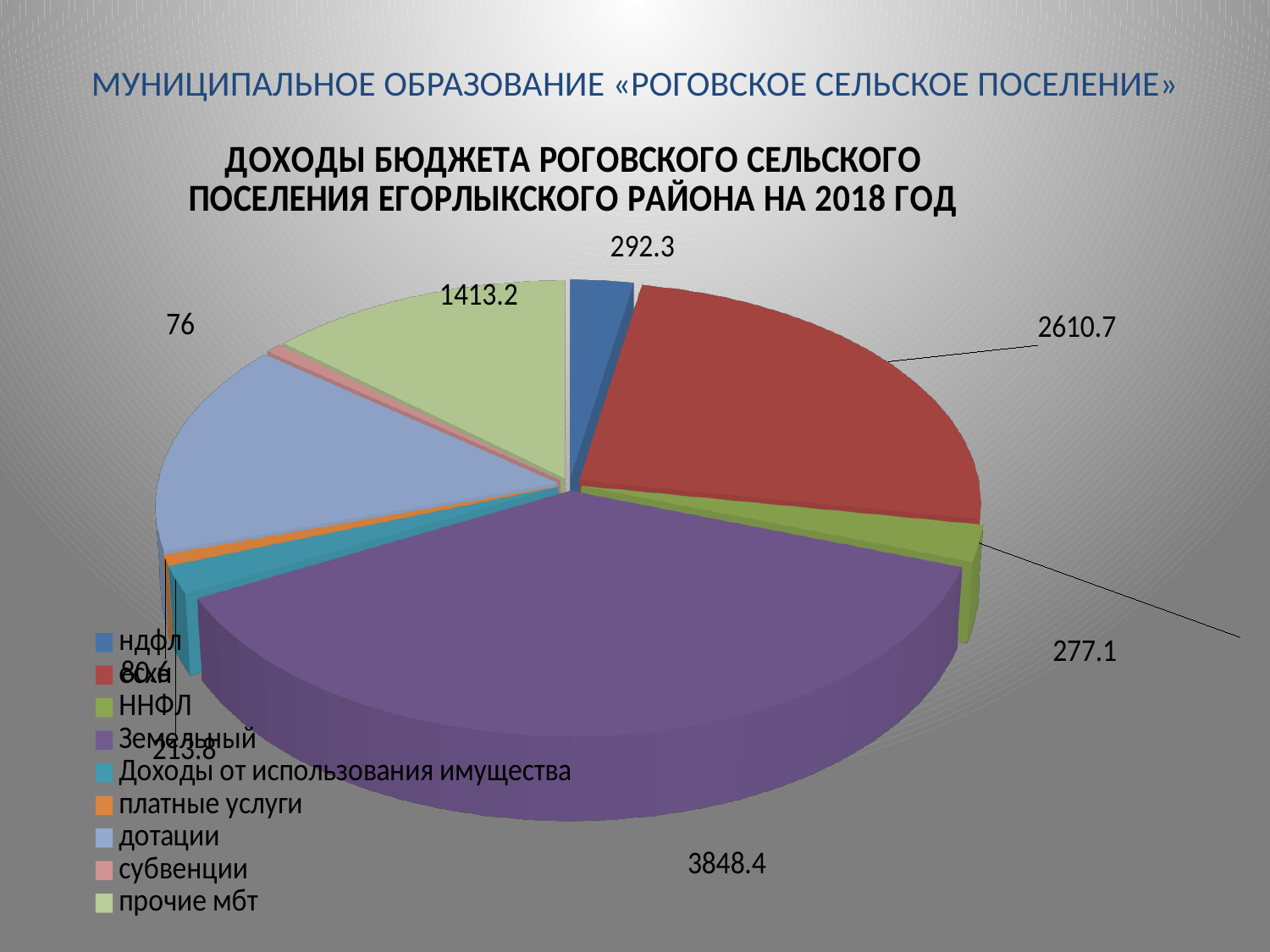
What is the value shown for the ндфл slice? 292.3 Which category has the largest slice in the pie chart? Земельный What is the difference between the есхн value and the ндфл value? 2318.4 How many categories does the legend of the pie chart list? 9 What is the value shown for the Земельный slice? 3848.4 Which is larger, the есхн slice or the ндфл slice? есхн What is the value shown for the есхн slice? 2610.7 What is the value shown for the ННФЛ slice? 277.1 What colour is the Земельный slice in the pie chart? purple What is the difference between the Земельный value and the есхн value? 1237.7 What is the title of the pie chart? ДОХОДЫ БЮДЖЕТА РОГОВСКОГО СЕЛЬСКОГО ПОСЕЛЕНИЯ ЕГОРЛЫКСКОГО РАЙОНА НА 2018 ГОД What kind of chart is shown on the slide? pie chart